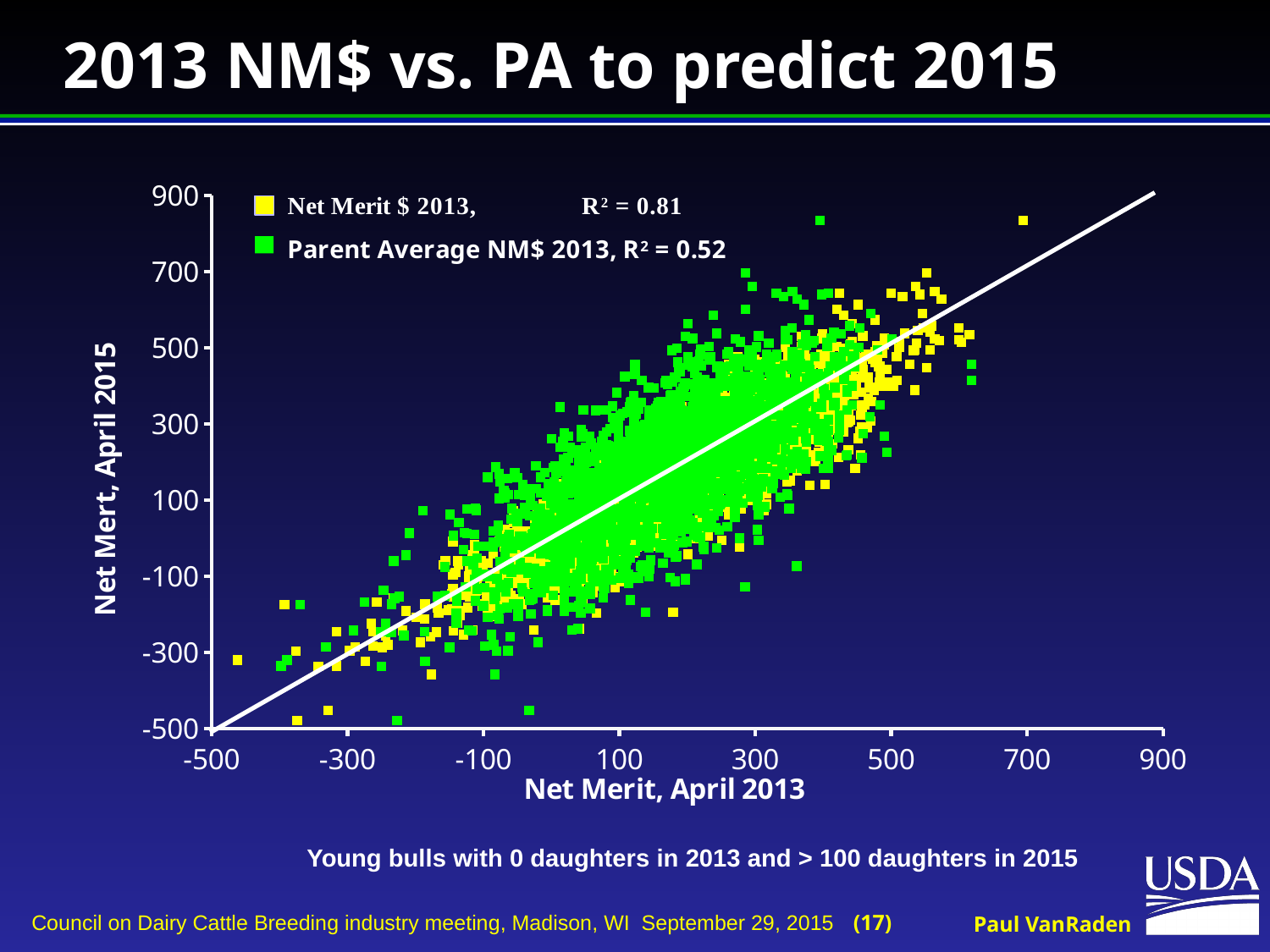
What is the highest value shown on the y axis? 900 What is the difference between the R² values of the two series? 0.29 Which series has the higher R², Net Merit $ 2013 or Parent Average NM$ 2013? Net Merit $ 2013 Do the plotted values on the y axis generally rise or fall as the x-axis value increases? rise What is the R² value for the Parent Average NM$ 2013 series? 0.52 What kind of chart is shown on the slide? scatter plot What is the lowest value shown on the x axis? -500 How many series does the legend list? 2 What is the R² value for the Net Merit $ 2013 series? 0.81 Which colour represents the Parent Average NM$ 2013 series? green What is the label of the x axis? Net Merit, April 2013